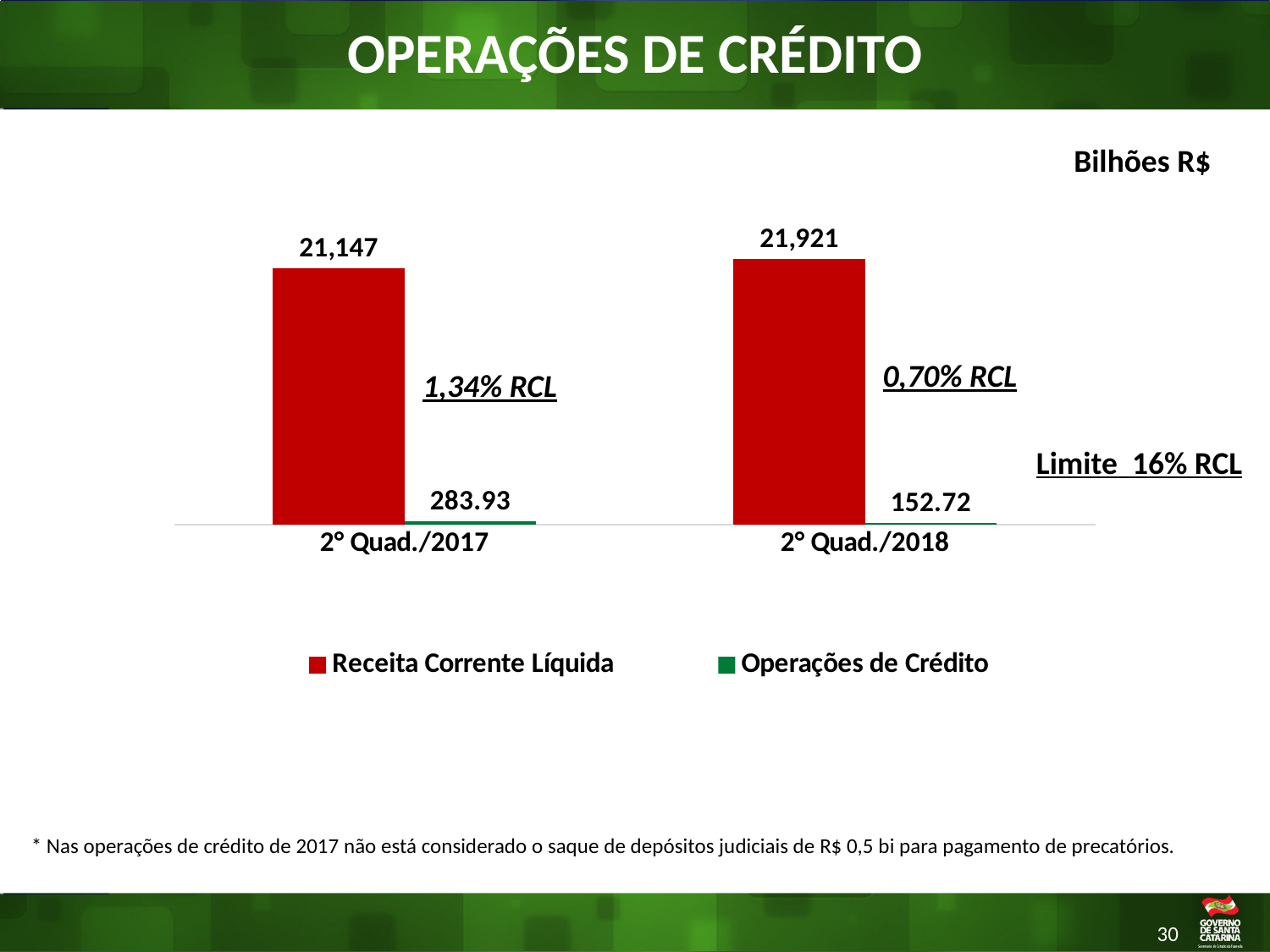
What is the difference between the Operações de Crédito values for 2° Quad./2017 and 2° Quad./2018? 131.21 What is the value of Receita Corrente Líquida for 2° Quad./2018? 21,921 Which period has the higher value for Operações de Crédito? 2° Quad./2017 Which period has the lower value for Receita Corrente Líquida? 2° Quad./2017 What percentage of RCL do the Operações de Crédito represent in 2° Quad./2018, according to the annotation on the chart? 0,70% RCL What is the value of Receita Corrente Líquida for 2° Quad./2017? 21,147 What is the value of Operações de Crédito for 2° Quad./2018? 152.72 What type of chart is shown on the slide? Bar chart How many series does the chart legend list? 2 Is the Receita Corrente Líquida value larger in 2° Quad./2017 or in 2° Quad./2018? 2° Quad./2018 How many periods are shown on the x axis of the chart? 2 What is the value of Operações de Crédito for 2° Quad./2017? 283.93